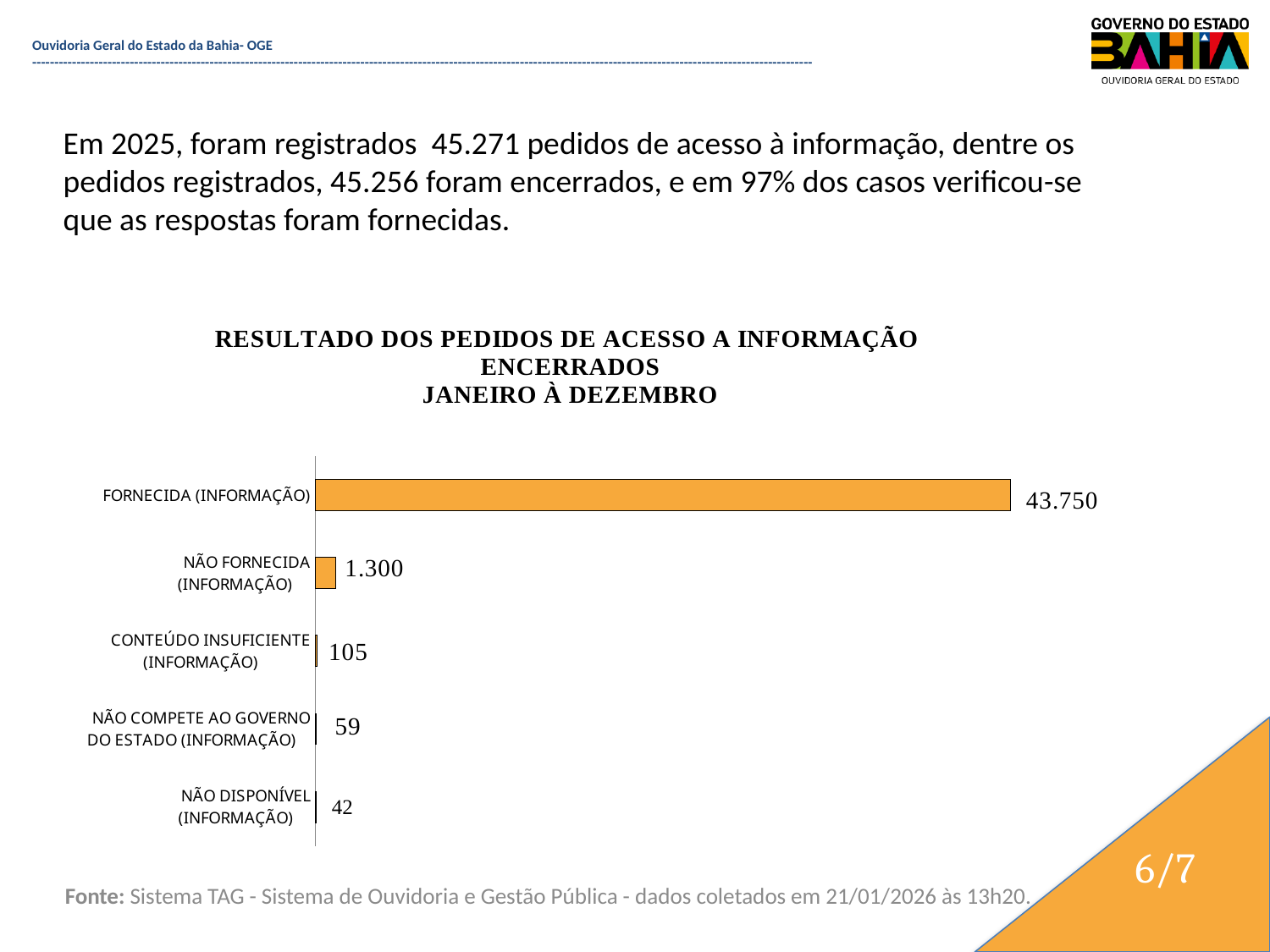
What is the value for CONTEÚDO INSUFICIENTE (INFORMAÇÃO)? 105 How many categories are shown in the chart? 5 What kind of chart is shown on the slide? Bar chart What is the value for NÃO FORNECIDA (INFORMAÇÃO)? 1.300 What is the value for FORNECIDA (INFORMAÇÃO)? 43.750 Which is larger, the value for CONTEÚDO INSUFICIENTE (INFORMAÇÃO) or the value for NÃO COMPETE AO GOVERNO DO ESTADO (INFORMAÇÃO)? CONTEÚDO INSUFICIENTE (INFORMAÇÃO) What is the difference between the values for NÃO FORNECIDA (INFORMAÇÃO) and CONTEÚDO INSUFICIENTE (INFORMAÇÃO)? 1.195 What is the difference between the values for NÃO COMPETE AO GOVERNO DO ESTADO (INFORMAÇÃO) and NÃO DISPONÍVEL (INFORMAÇÃO)? 17 What is the value for NÃO DISPONÍVEL (INFORMAÇÃO)? 42 Which category has the highest value? FORNECIDA (INFORMAÇÃO) Which category has the lowest value? NÃO DISPONÍVEL (INFORMAÇÃO) What is the value for NÃO COMPETE AO GOVERNO DO ESTADO (INFORMAÇÃO)? 59